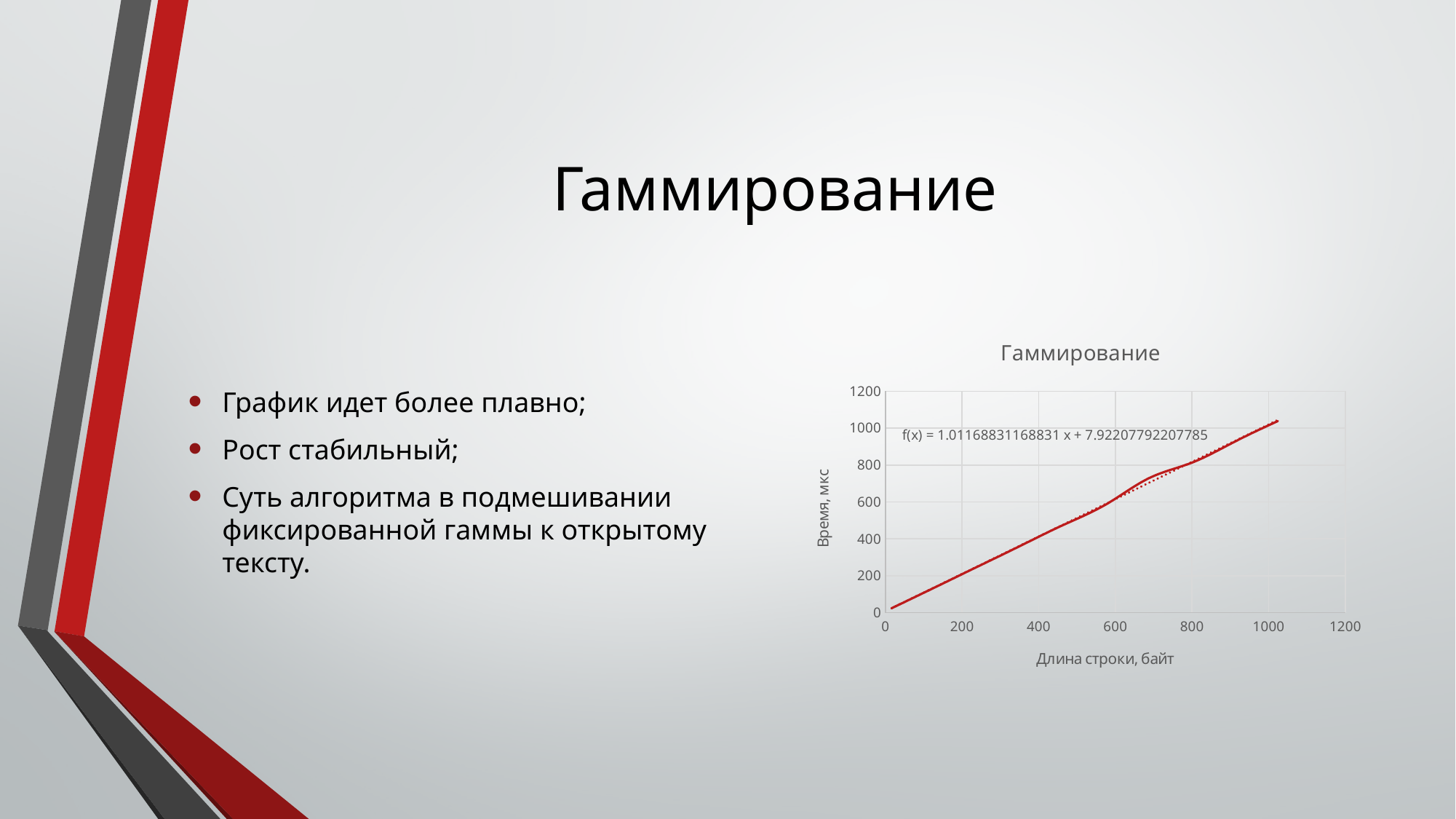
Is the value for a string length of 600 bytes greater or less than 400? greater Which has the larger value on the chart: a string length of 400 bytes or 800 bytes? 800 bytes Is the value for a string length of 600 bytes greater or less than 800? less Do the values on the chart rise or fall as the string length increases along the x axis? rise Is the value for a string length of 200 bytes greater or less than 400? less What is the label of the x axis of the chart? Длина строки, байт What kind of chart is shown on the slide? line chart What is the title of the chart on the slide? Гаммирование What is the highest tick value shown on the y axis of the chart? 1200